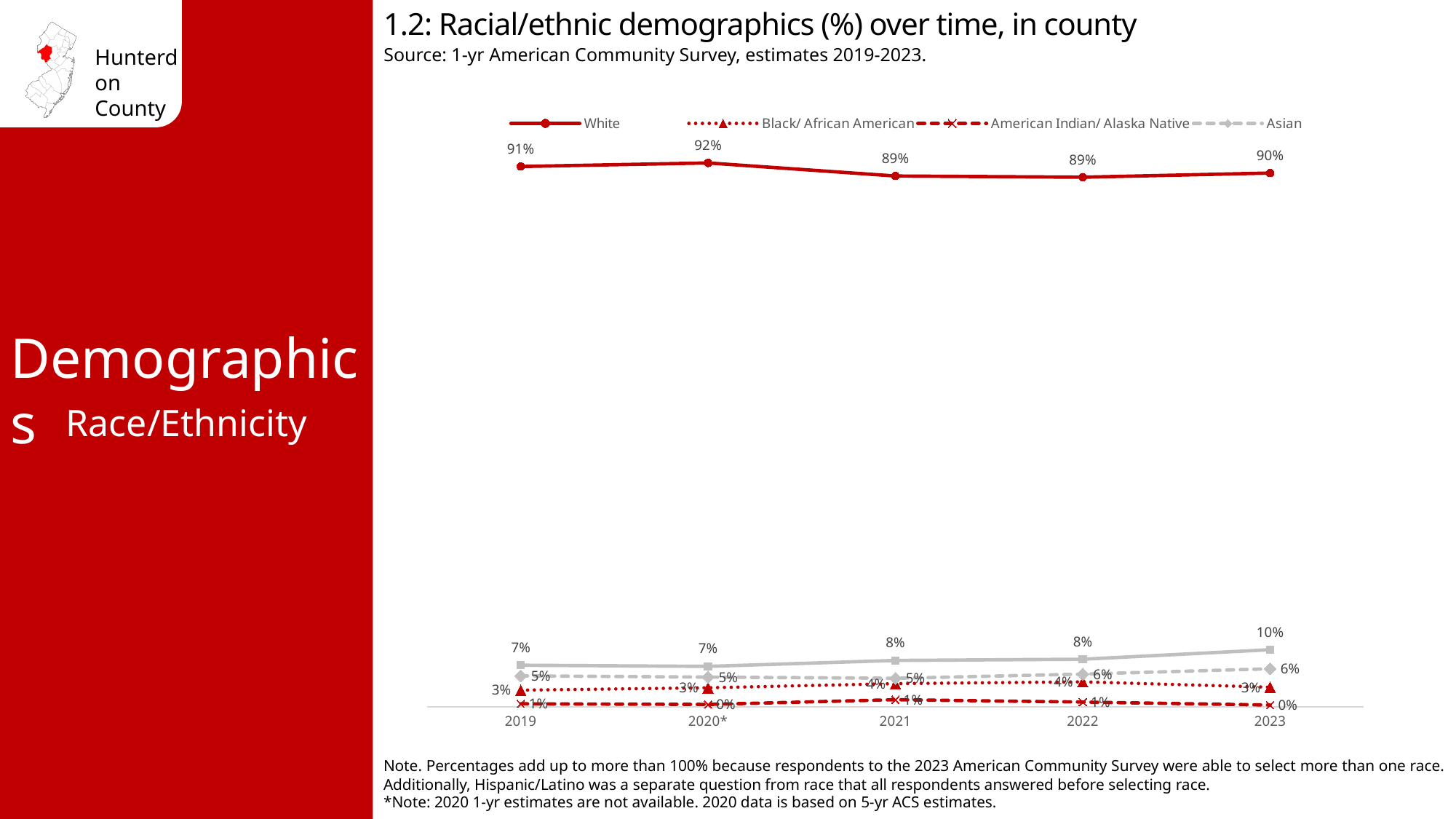
What was the Black/ African American percentage in 2021? 4% Which year on the x axis is marked with an asterisk? 2020* Which was larger in 2023, the Asian percentage or the Black/ African American percentage? Asian How many years are shown on the x axis? 5 What was the White percentage in 2023? 90% In which year was the White percentage highest? 2020* What was the Asian percentage in 2022? 6% What is the difference between the White percentage in 2020* and in 2021? 3% What was the American Indian/ Alaska Native percentage in 2020*? 0% Did the Asian percentage rise or fall from 2019 to 2023? rise What type of chart is shown on the slide? line chart What was the White percentage in 2019? 91%